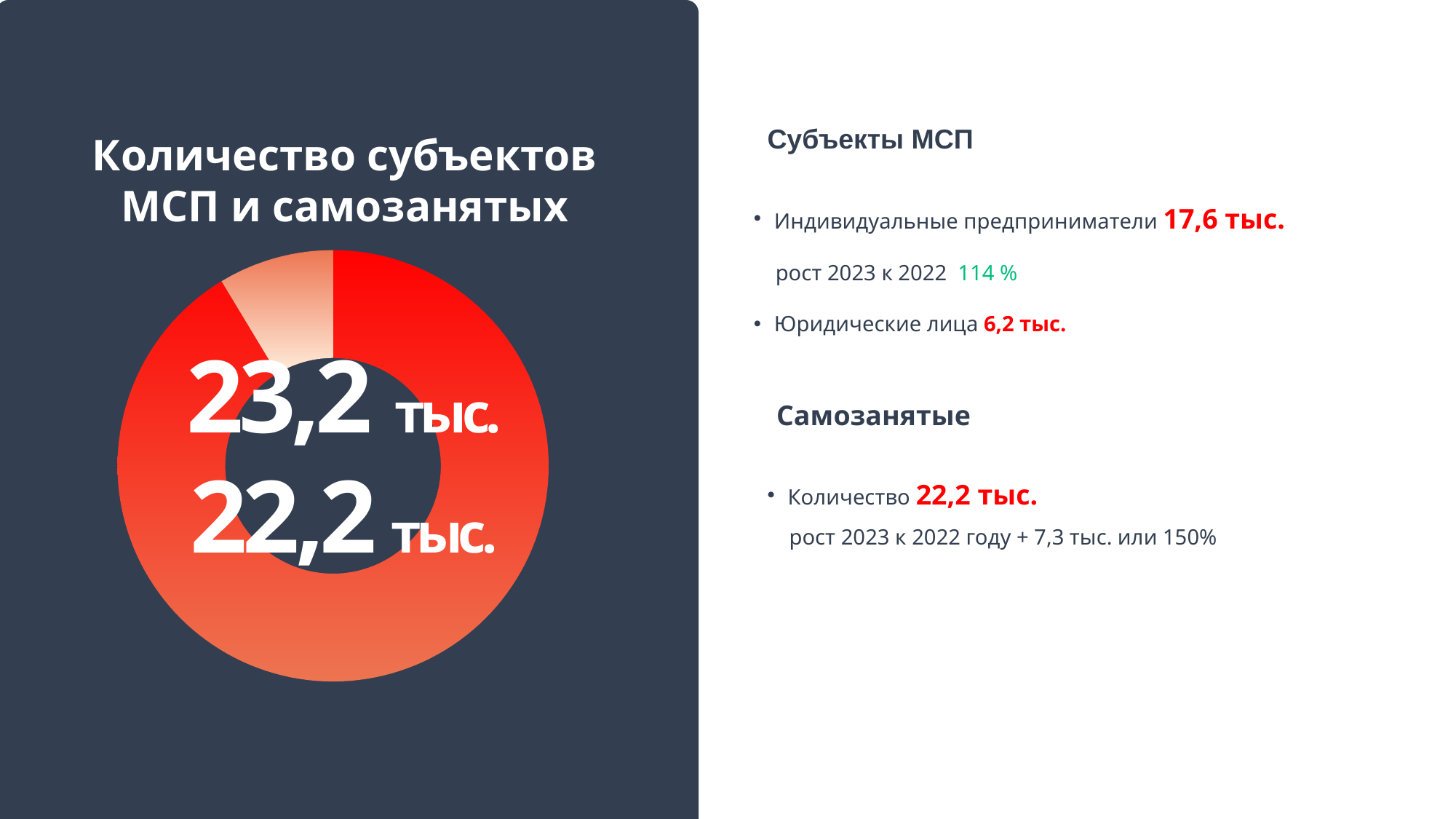
Does the light slice of the donut chart take up more or less than half of the ring? less What is the second value printed in the centre of the donut chart? 22,2 тыс. What is the title of the chart? Количество субъектов МСП и самозанятых How many slices does the donut chart have? 2 What kind of chart is shown on the slide? pie chart (donut) Which slice of the donut chart is larger, the red one or the light one? the red one What is the first value printed in the centre of the donut chart? 23,2 тыс. Which slice of the donut chart is the smallest? the light (pale) slice